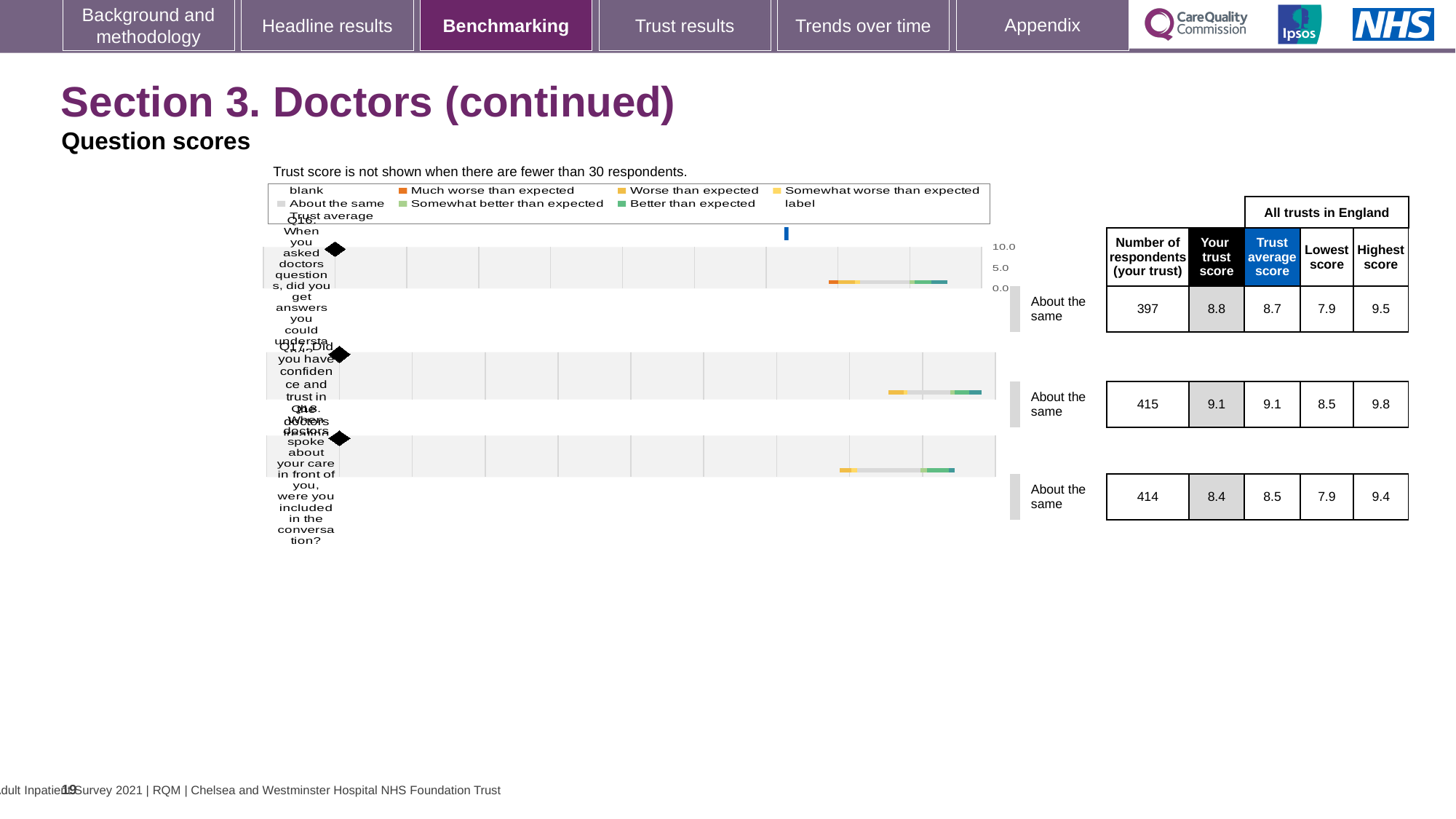
What is your trust score for Q16, about getting answers you could understand when you asked doctors questions? 8.8 Which of the three questions has the lowest 'Your trust score'? Q18 What is the trust average score for Q18, about being included in the conversation when doctors spoke about your care? 8.5 How many questions (categories) are plotted in the question scores chart? 3 What is the lowest score across all trusts in England for Q16? 7.9 Which of the three questions has the highest 'Your trust score'? Q17 What benchmark category is shown for all three questions on this slide? About the same What is the difference between the highest score and the lowest score for Q18? 1.5 What kind of chart is used to show the question scores on this slide? bar chart Is your trust score for Q16 larger or smaller than the trust average score for Q16? larger What is the highest score across all trusts in England for Q17? 9.8 What is the number of respondents (your trust) for Q17, about having confidence and trust in the doctors? 415